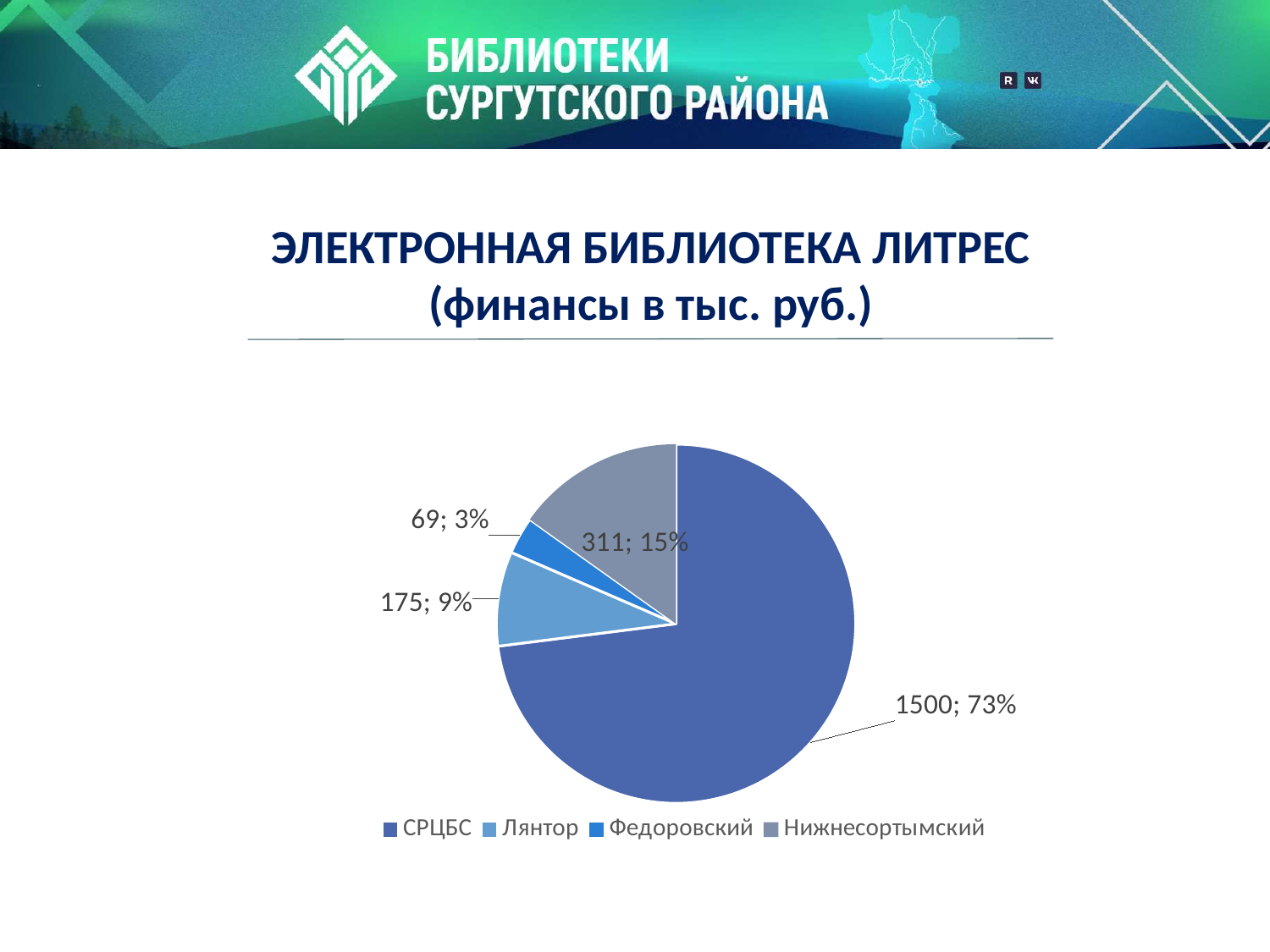
What is the value for Нижнесортымский? 311 Which category has the largest slice of the pie? СРЦБС How many categories does the legend list? 4 What is the value for СРЦБС? 1500 What share of the pie does Нижнесортымский have? 15% What is the difference between the values for Нижнесортымский and Лянтор? 136 What share of the pie does Лянтор have? 9% What kind of chart is shown on the slide? pie chart What is the value for Лянтор? 175 What is the value for Федоровский? 69 Which category has the smallest slice of the pie? Федоровский Which is larger, the value for Лянтор or the value for Федоровский? Лянтор